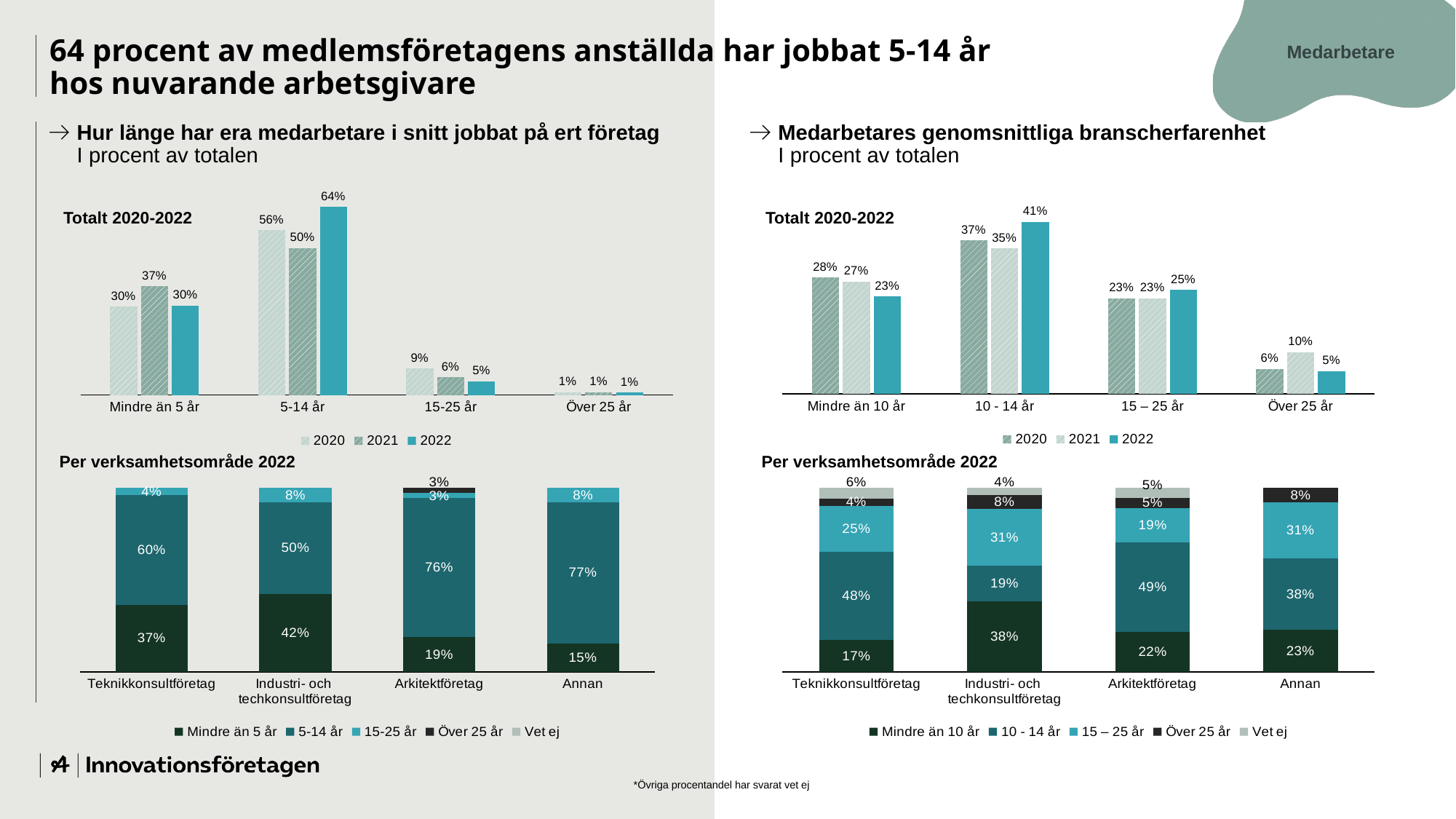
In the top-left chart 'Hur länge har era medarbetare i snitt jobbat på ert företag' (Totalt 2020-2022), which category has the lowest values across all years? Över 25 år In the top-left chart 'Hur länge har era medarbetare i snitt jobbat på ert företag' (Totalt 2020-2022), what is the value for 5-14 år in 2022? 64% In the top-right chart 'Medarbetares genomsnittliga branscherfarenhet' (Totalt 2020-2022), which is larger for Över 25 år: the 2021 value or the 2022 value? 2021 In the top-left chart 'Hur länge har era medarbetare i snitt jobbat på ert företag' (Totalt 2020-2022), what is the value for Mindre än 5 år in 2021? 37% In the top-left chart 'Hur länge har era medarbetare i snitt jobbat på ert företag' (Totalt 2020-2022), what is the difference between the 2022 and 2021 values for 5-14 år? 14% What kind of chart is the bottom-left chart 'Per verksamhetsområde 2022' (left side of the slide)? Stacked bar chart In the bottom-left chart 'Per verksamhetsområde 2022' (left side of the slide), which category has the highest share of 5-14 år? Annan In the top-right chart 'Medarbetares genomsnittliga branscherfarenhet' (Totalt 2020-2022), what is the value for 10 - 14 år in 2022? 41% How many series does the legend of the bottom-right chart 'Per verksamhetsområde 2022' (right side of the slide) list? 5 How many series does the legend of the top-left chart 'Hur länge har era medarbetare i snitt jobbat på ert företag' (Totalt 2020-2022) list? 3 In the bottom-right chart 'Per verksamhetsområde 2022' (right side of the slide), what is the share of 15 – 25 år for Industri- och techkonsultföretag? 31% In the bottom-left chart 'Per verksamhetsområde 2022' (left side of the slide), what is the share of Mindre än 5 år for Industri- och techkonsultföretag? 42%